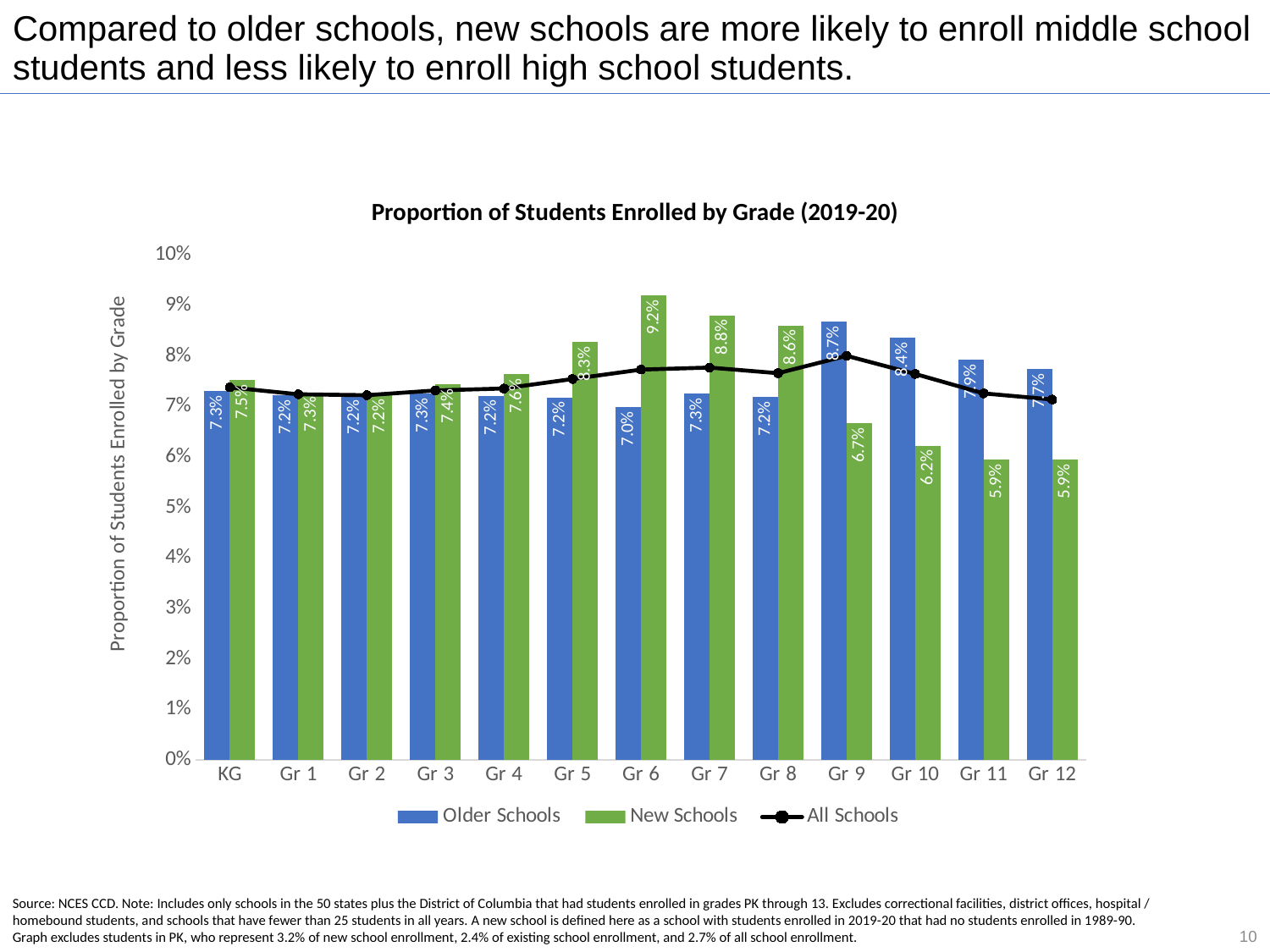
Is the All Schools value at Gr 12 greater or less than 8%? less What is the value for New Schools at Gr 6? 9.2% How many series does the legend list? 3 At Gr 5, which is larger: Older Schools or New Schools? New Schools Which grade has the lowest value for Older Schools? Gr 6 What is the value for Older Schools at Gr 9? 8.7% How many grade categories are shown on the x axis? 13 Which grade has the highest value for New Schools? Gr 6 What kind of chart is used to plot the Older Schools and New Schools series? bar chart Do the New Schools values rise or fall from Gr 9 to Gr 12? fall What is the difference between the Older Schools and New Schools values at Gr 9? 2.0 percentage points What is the value for New Schools at Gr 10? 6.2%